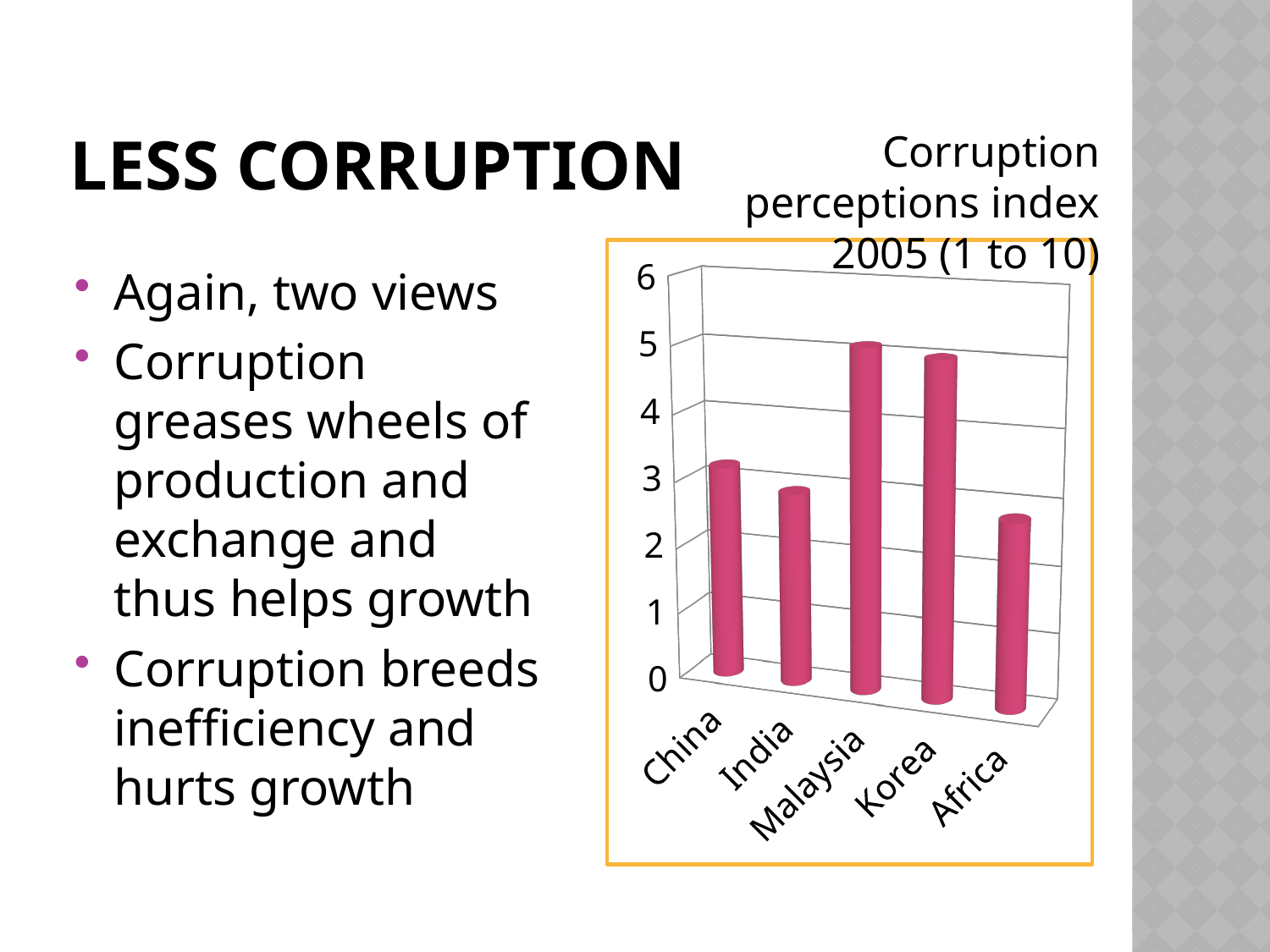
Is the value for China greater or less than 4? less Is the value for Africa greater or less than 3? less How many categories are shown on the x axis of the chart? 5 Is the value for Malaysia greater or less than 4? greater What is the title of the chart? Corruption perceptions index 2005 (1 to 10) Which has a higher value, China or Africa? China Which has a higher value, Malaysia or India? Malaysia Which has a higher value, Korea or Africa? Korea Which category has the lowest corruption perceptions index value? Africa What kind of chart is shown on the slide? bar chart